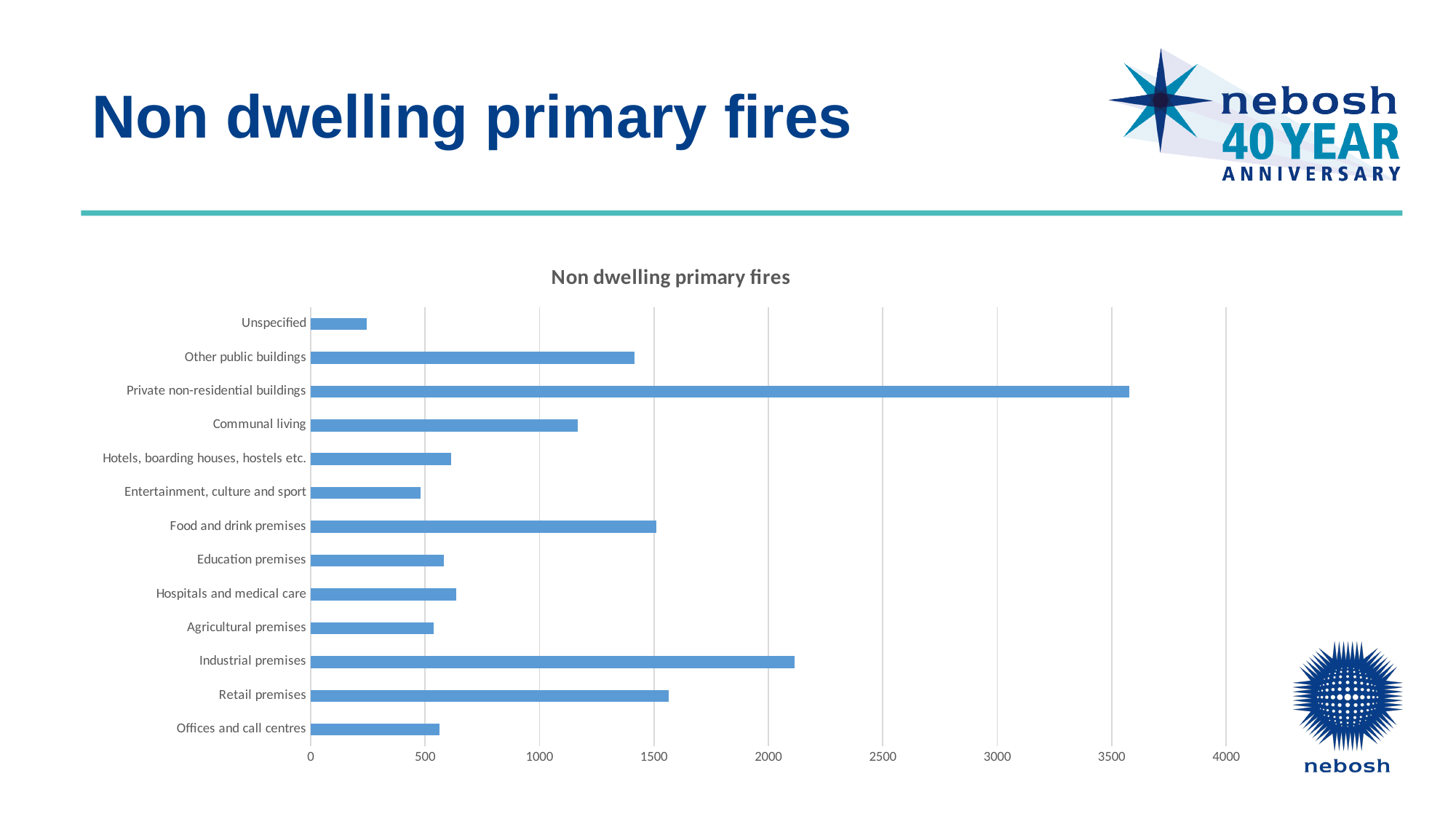
How many categories are plotted in the chart? 13 Is the value for Other public buildings greater or less than 1500? less Is the value for Industrial premises greater or less than 2000? greater Which category has the highest number of non dwelling primary fires? Private non-residential buildings Is the value for Unspecified greater or less than 500? less Which has the larger value, Food and drink premises or Communal living? Food and drink premises Which has the larger value, Industrial premises or Retail premises? Industrial premises Which category has the lowest number of non dwelling primary fires? Unspecified What is the title of the chart? Non dwelling primary fires What kind of chart is shown on the slide? bar chart